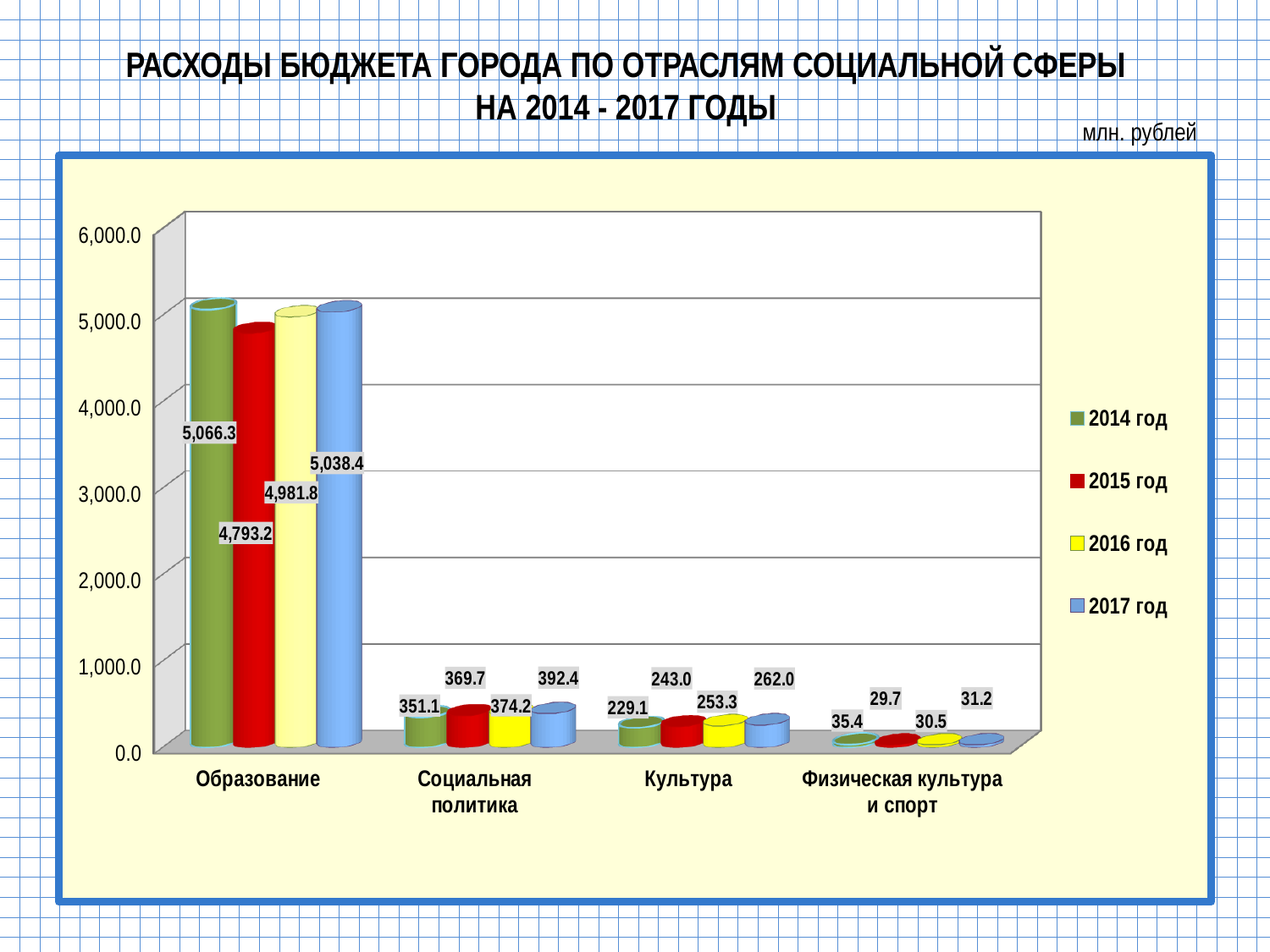
How many categories are shown on the x axis? 4 Which is larger for Образование: the 2016 год value or the 2017 год value? 2017 год What is the difference between the 2014 год and 2015 год values for Образование? 273.1 How many series does the legend list? 4 What is the value for Физическая культура и спорт in 2015 год? 29.7 Do the values for Культура rise or fall from 2014 год to 2017 год? rise What is the value for Культура in 2016 год? 253.3 What is the value for Образование in 2014 год? 5,066.3 What is the difference between the 2017 год and 2014 год values for Социальная политика? 41.3 Which category has the highest value in 2017 год? Образование Which category has the lowest value in 2014 год? Физическая культура и спорт What is the value for Социальная политика in 2017 год? 392.4